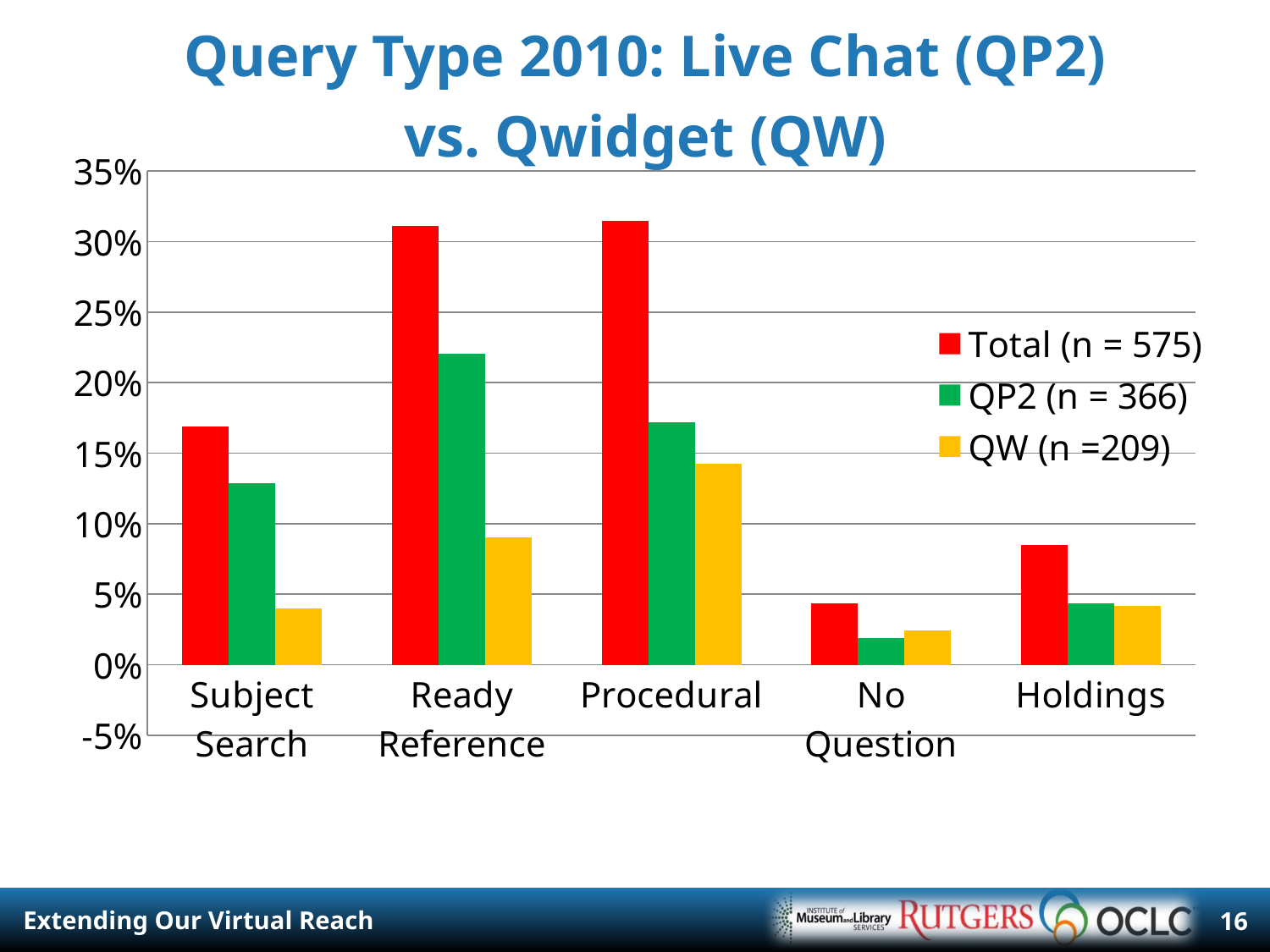
Is the QW (n =209) value for Subject Search greater or less than 5%? less For the Total (n = 575) series, which category has the lowest value? No Question Is the Total (n = 575) value for Ready Reference greater or less than 30%? greater Which colour represents the Total (n = 575) series? red How many query type categories are shown on the x axis? 5 For the QP2 (n = 366) series, which category has the highest value? Ready Reference For the QW (n =209) series, which category has the highest value? Procedural Is the QP2 (n = 366) value for Ready Reference greater or less than 20%? greater For Subject Search, which is larger: the QP2 (n = 366) value or the QW (n =209) value? QP2 (n = 366) What kind of chart is shown on the slide? bar chart How many series does the legend list? 3